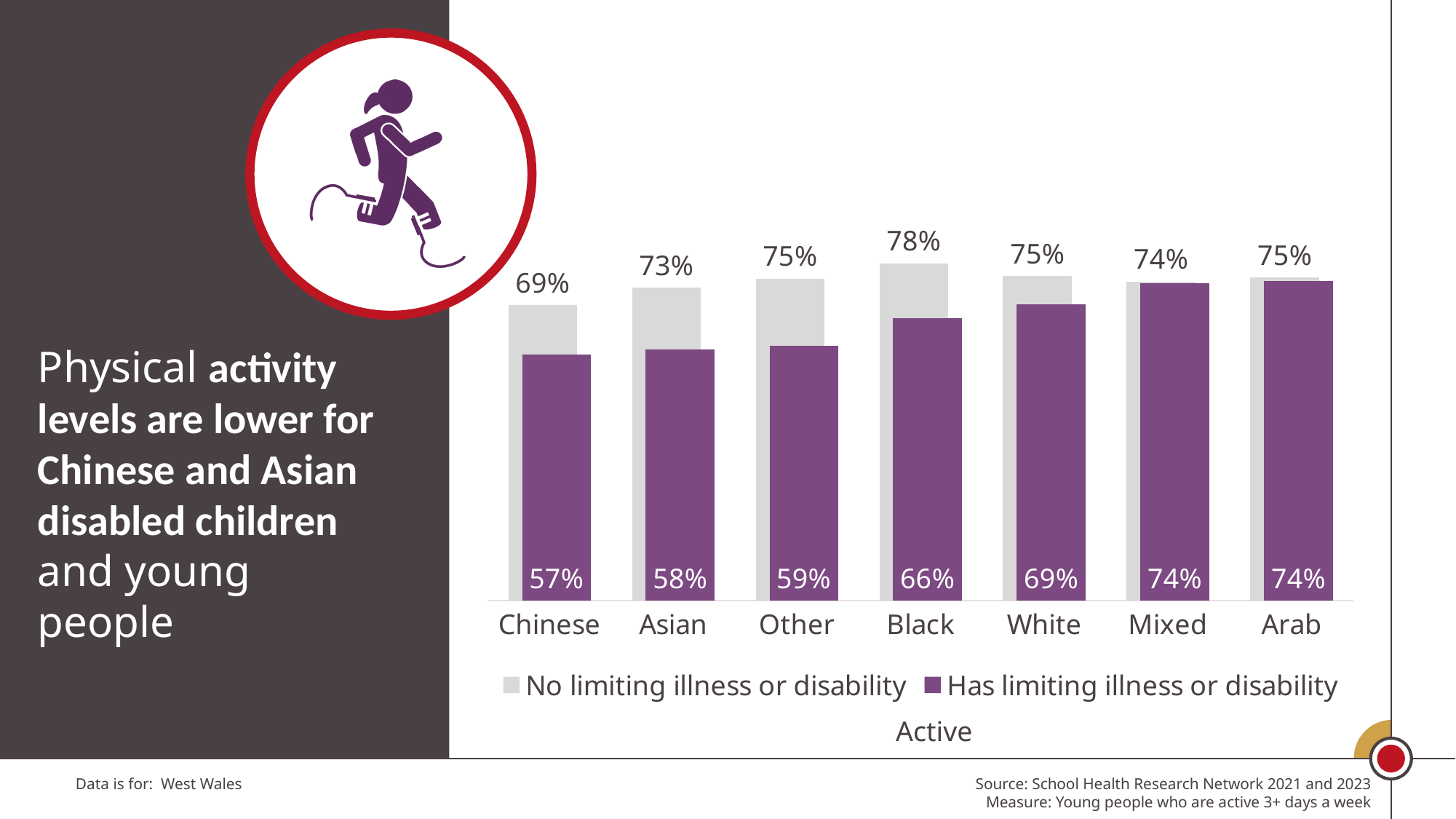
Which is larger: the 'Has limiting illness or disability' value for Black or for Asian? Black What is the value for Black in the 'No limiting illness or disability' series? 78% How many categories are shown on the x axis? 7 What is the value for White in the 'Has limiting illness or disability' series? 69% Which category has the highest value in the 'No limiting illness or disability' series? Black What kind of chart is shown on the slide? Bar chart Which colour represents the 'Has limiting illness or disability' series? Purple What is the difference between the 'No limiting illness or disability' and 'Has limiting illness or disability' values for Chinese? 12% How many series does the legend list? 2 Which category has the lowest value in the 'Has limiting illness or disability' series? Chinese What is the difference between the 'No limiting illness or disability' and 'Has limiting illness or disability' values for Other? 16% What is the value for Chinese in the 'Has limiting illness or disability' series? 57%